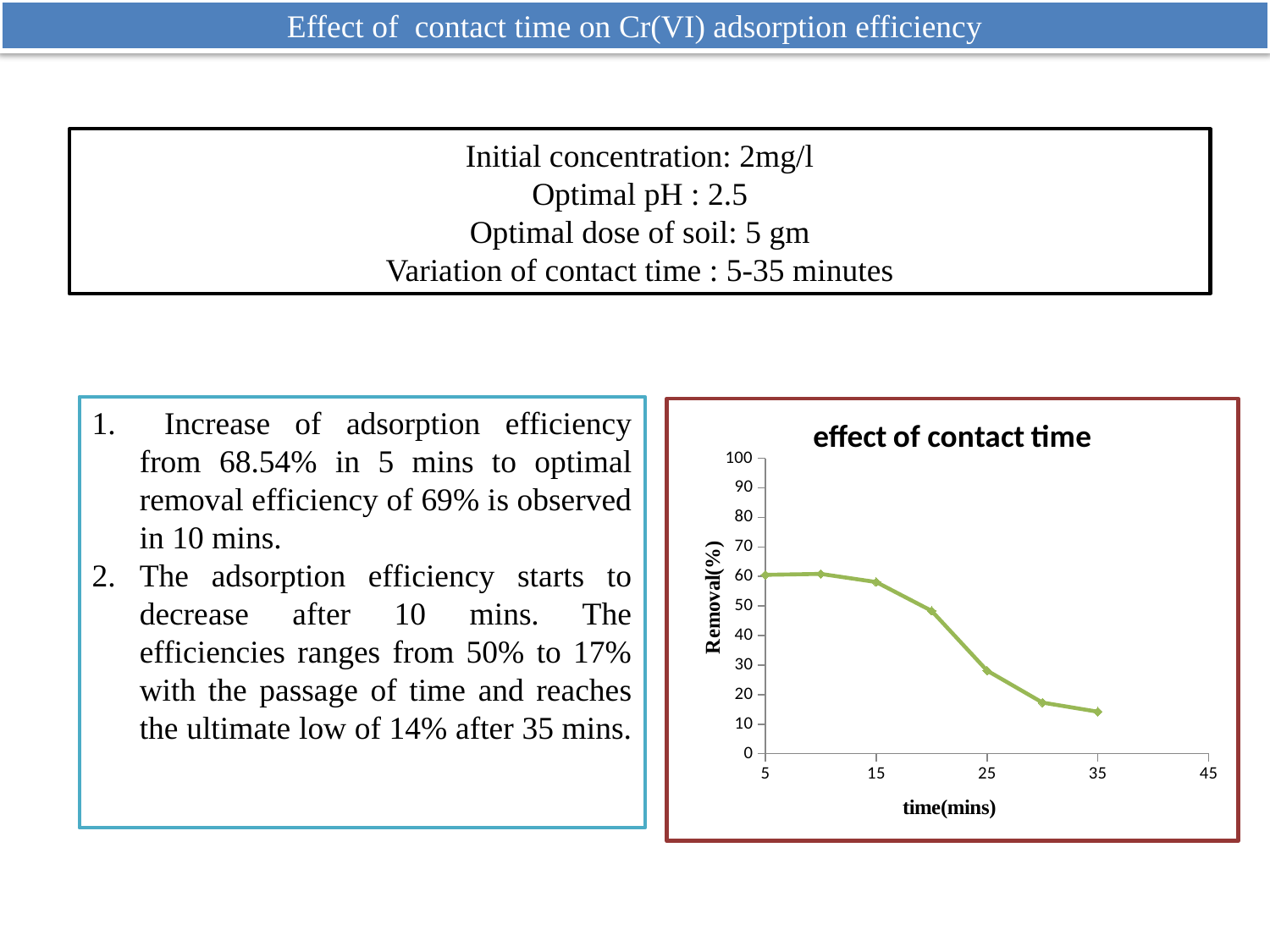
Is the value for 25 mins greater or less than 40? less What kind of chart is shown on the slide? line chart Do the removal values generally rise or fall as time increases along the x axis? fall Which has the larger removal value, 5 mins or 25 mins? 5 mins What is the title of the chart? effect of contact time Is the value for 35 mins greater or less than 20? less What is the label of the y axis of the chart? Removal(%) Is the value for 15 mins greater or less than 50? greater Which has the larger removal value, 20 mins or 30 mins? 20 mins How many data points are plotted on the line? 7